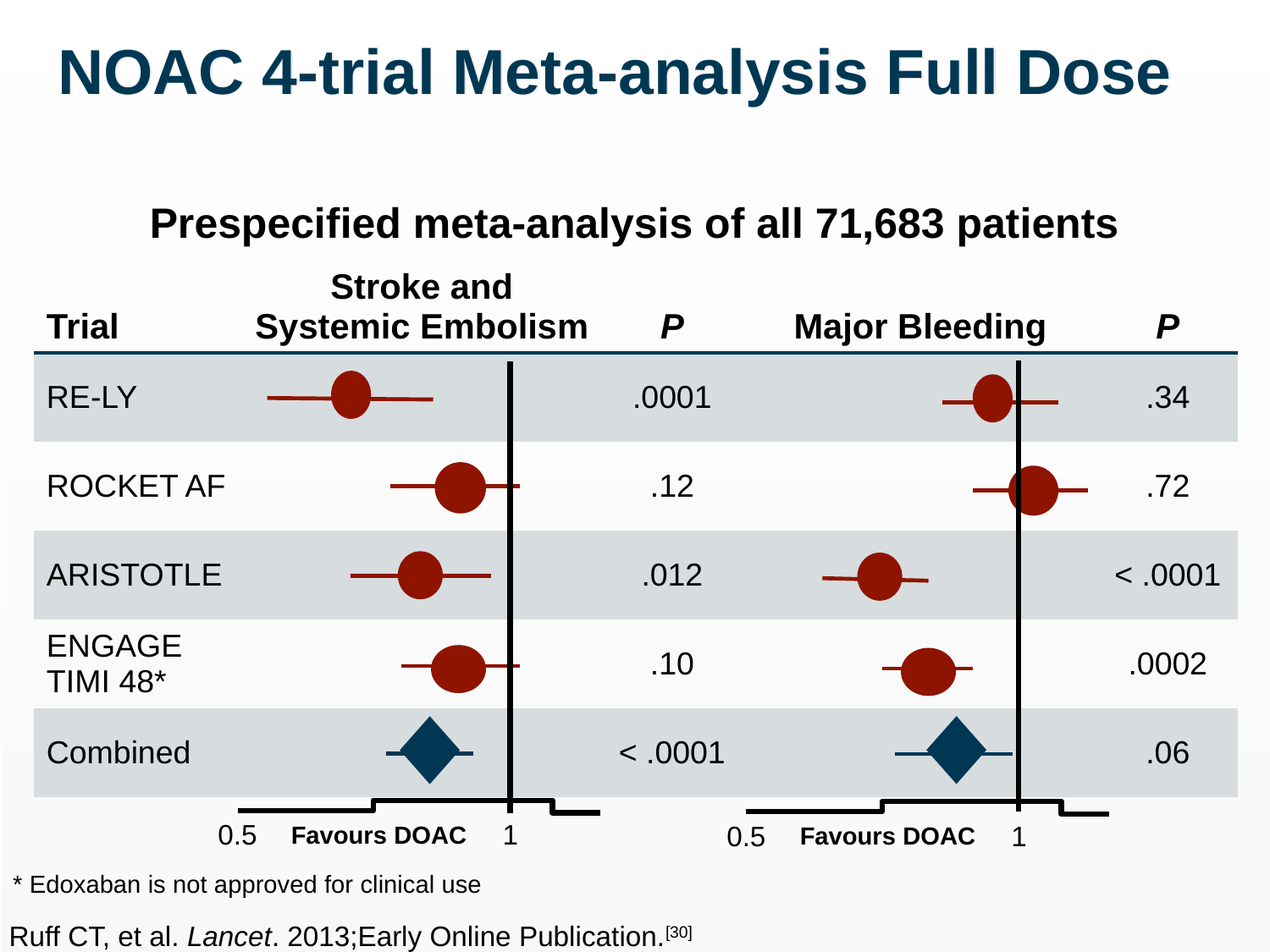
In the Stroke and Systemic Embolism panel, is the point estimate for RE-LY greater or less than 1? less In the Major Bleeding panel, what is the P value for ROCKET AF? .72 How many rows (trials plus the combined estimate) are plotted in each panel? 5 In the Stroke and Systemic Embolism panel, what is the P value for the Combined estimate? < .0001 In the Major Bleeding panel, is the point estimate for ARISTOTLE greater or less than 1? less In the Stroke and Systemic Embolism panel, what is the P value for RE-LY? .0001 In the Major Bleeding panel, which row has the highest P value? ROCKET AF What kind of chart is shown on the slide? Forest plot In the Stroke and Systemic Embolism panel, which of the four individual trials has the highest P value? ROCKET AF In the Major Bleeding panel, what is the P value for ENGAGE TIMI 48*? .0002 In the Major Bleeding panel, what is the P value for ARISTOTLE? < .0001 In the Stroke and Systemic Embolism panel, is the P value for ROCKET AF larger or smaller than the P value for ENGAGE TIMI 48*? larger